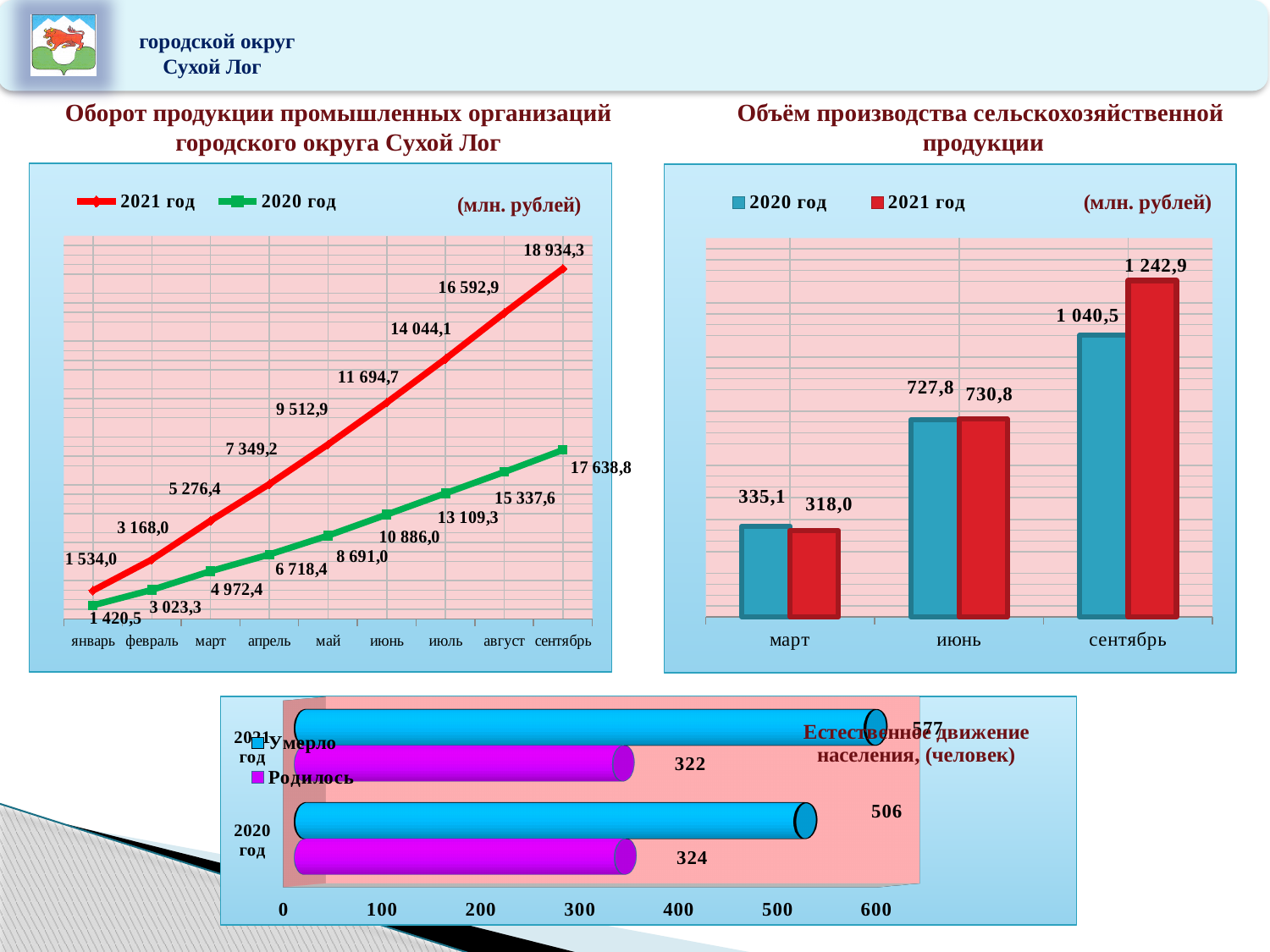
In the chart 'Оборот продукции промышленных организаций городского округа Сухой Лог', how many months are shown on the x axis? 9 How many series does the legend of the chart 'Объём производства сельскохозяйственной продукции' list? 2 In the chart 'Объём производства сельскохозяйственной продукции', what is the difference between the 2021 год and 2020 год values in сентябрь? 202,4 In the chart 'Объём производства сельскохозяйственной продукции', which month has the lowest value for 2020 год? март In the chart 'Оборот продукции промышленных организаций городского округа Сухой Лог', what is the difference between the 2021 год and 2020 год values in январь? 113,5 In the chart 'Оборот продукции промышленных организаций городского округа Сухой Лог', what is the value for 2020 год in май? 8 691,0 In the chart 'Объём производства сельскохозяйственной продукции', what is the value for 2021 год in сентябрь? 1 242,9 In the chart 'Оборот продукции промышленных организаций городского округа Сухой Лог', what is the value for 2021 год in сентябрь? 18 934,3 In the chart 'Оборот продукции промышленных организаций городского округа Сухой Лог', do the values for 2021 год rise or fall from январь to сентябрь? rise What kind of chart is 'Оборот продукции промышленных организаций городского округа Сухой Лог'? line chart In the chart 'Естественное движение населения, (человек)', which is larger: Родилось in 2020 год or Родилось in 2021 год? Родилось in 2020 год In the chart 'Естественное движение населения, (человек)', what is the value for Умерло in 2021 год? 577